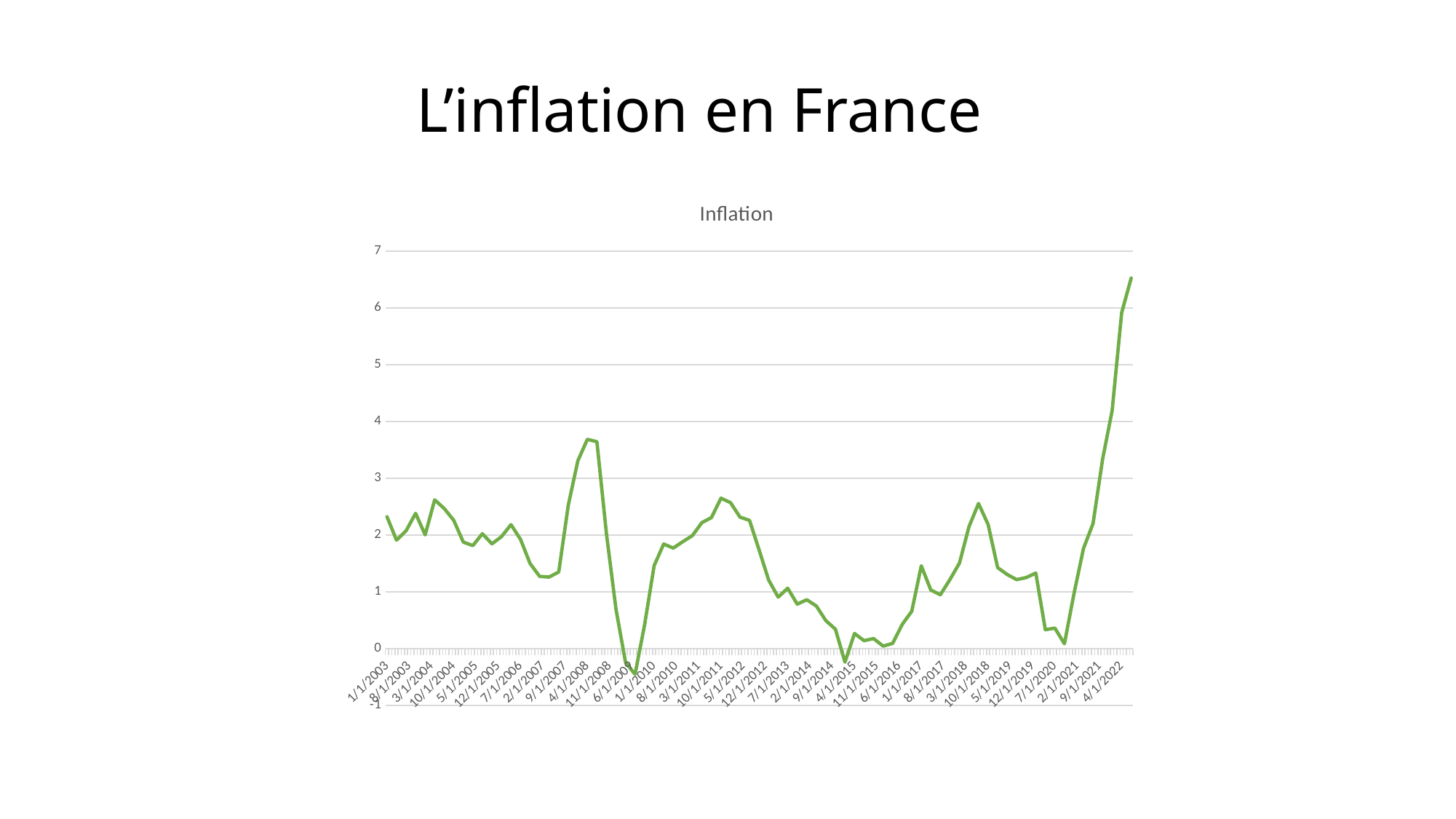
Between 2/1/2021 and 4/1/2022, does the line rise or fall? rise Is the value at 1/1/2003 greater or less than 3? less Is the value at 7/1/2020 greater or less than 1? less What is the title of the chart? Inflation Is the highest point on the line greater or less than 5? greater In which year does the line reach its lowest value? 2009 Which is larger, the value at 4/1/2022 or the value at 1/1/2003? 4/1/2022 What kind of chart is shown on the slide? line chart What colour is the line in the chart? green